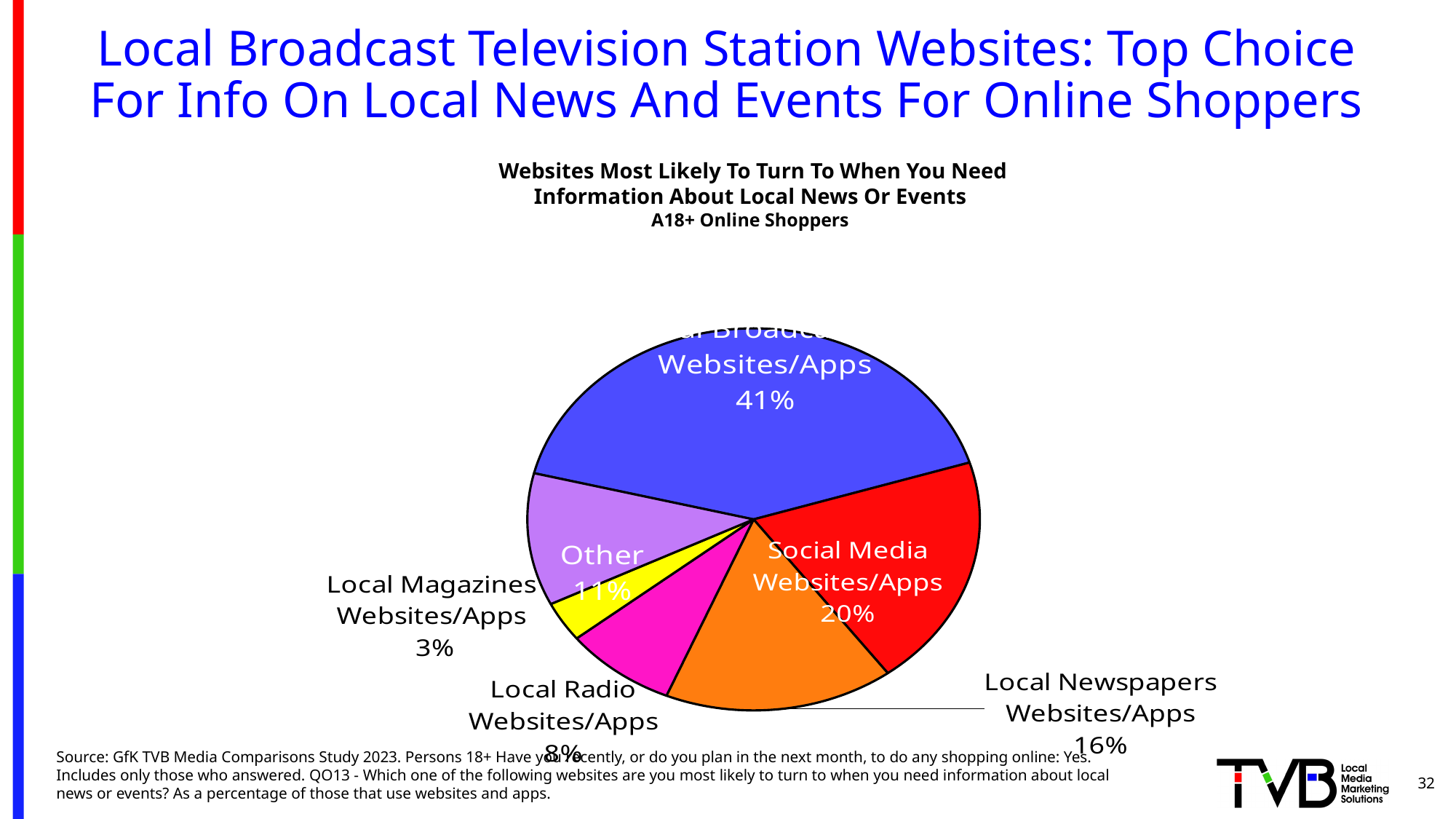
What percentage is shown for the Other slice? 11% What type of chart is shown on the slide? pie chart Which category has the smallest slice of the pie? Local Magazines Websites/Apps What percentage is shown for Local Magazines Websites/Apps? 3% What colour is the Social Media Websites/Apps slice? red What is the percentage shown on the largest slice of the pie? 41% What percentage is shown for Local Newspapers Websites/Apps? 16% How many slices does the pie chart have? 6 What is the difference in percentage points between Social Media Websites/Apps and Local Newspapers Websites/Apps? 4 percentage points Which is larger: Local Radio Websites/Apps or Other? Other What percentage of A18+ online shoppers chose Social Media Websites/Apps? 20% What percentage is shown for Local Radio Websites/Apps? 8%